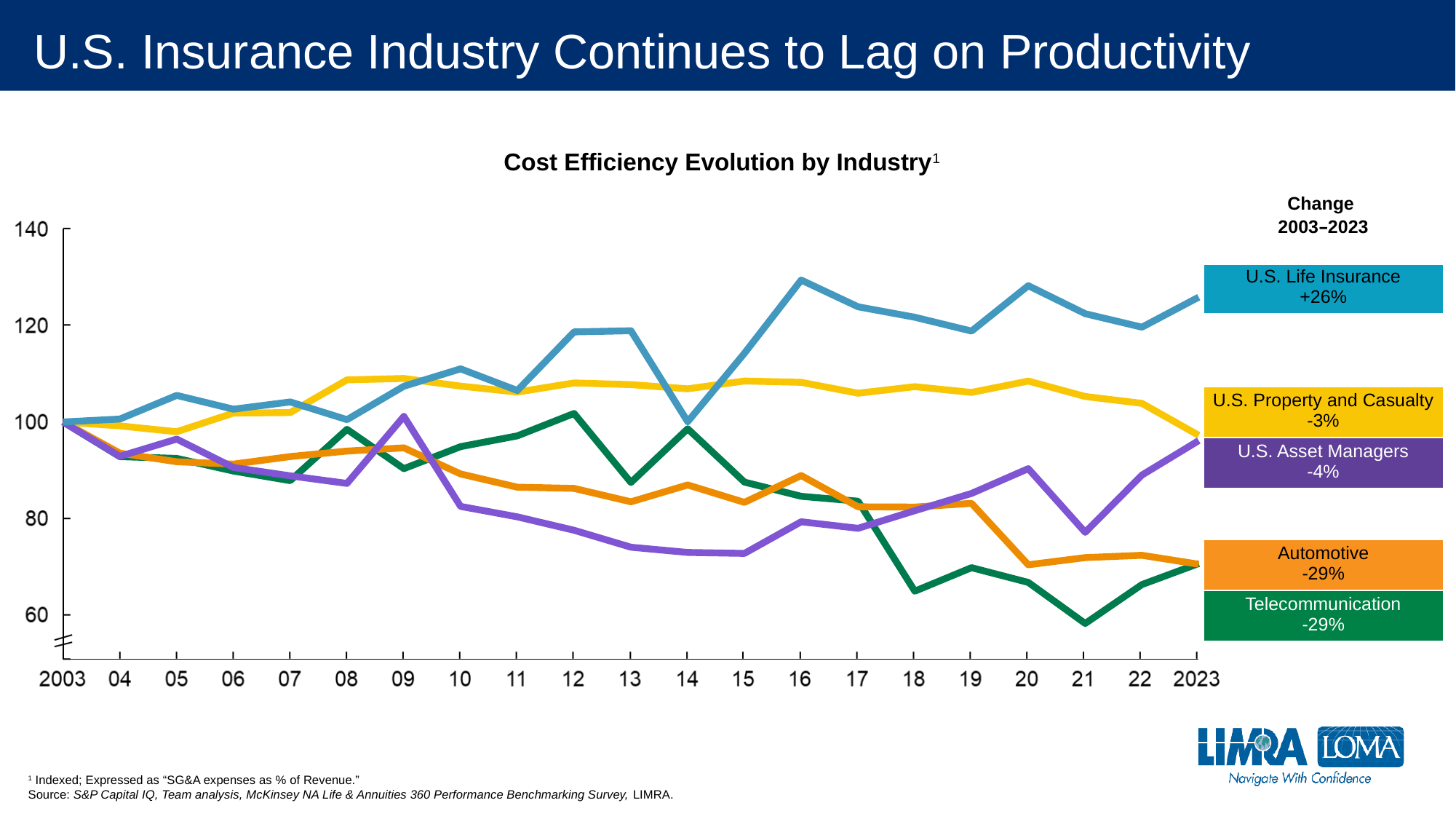
What is the change from 2003 to 2023 shown for Automotive? -29% How many industry series are plotted on the chart? 5 Does the Automotive line rise or fall overall from 2003 to 2023? fall What kind of chart is shown on the slide? line chart What is the change from 2003 to 2023 shown for U.S. Property and Casualty? -3% What is the change from 2003 to 2023 shown for U.S. Life Insurance? +26% What is the title of the chart? Cost Efficiency Evolution by Industry How many years are plotted along the x axis of the chart? 21 Is the value for U.S. Life Insurance in 2016 greater or less than 120? greater Is the value for Telecommunication in 2021 greater or less than 60? less Which industry has the highest change from 2003 to 2023? U.S. Life Insurance In 2023, which line is higher, U.S. Life Insurance or Automotive? U.S. Life Insurance